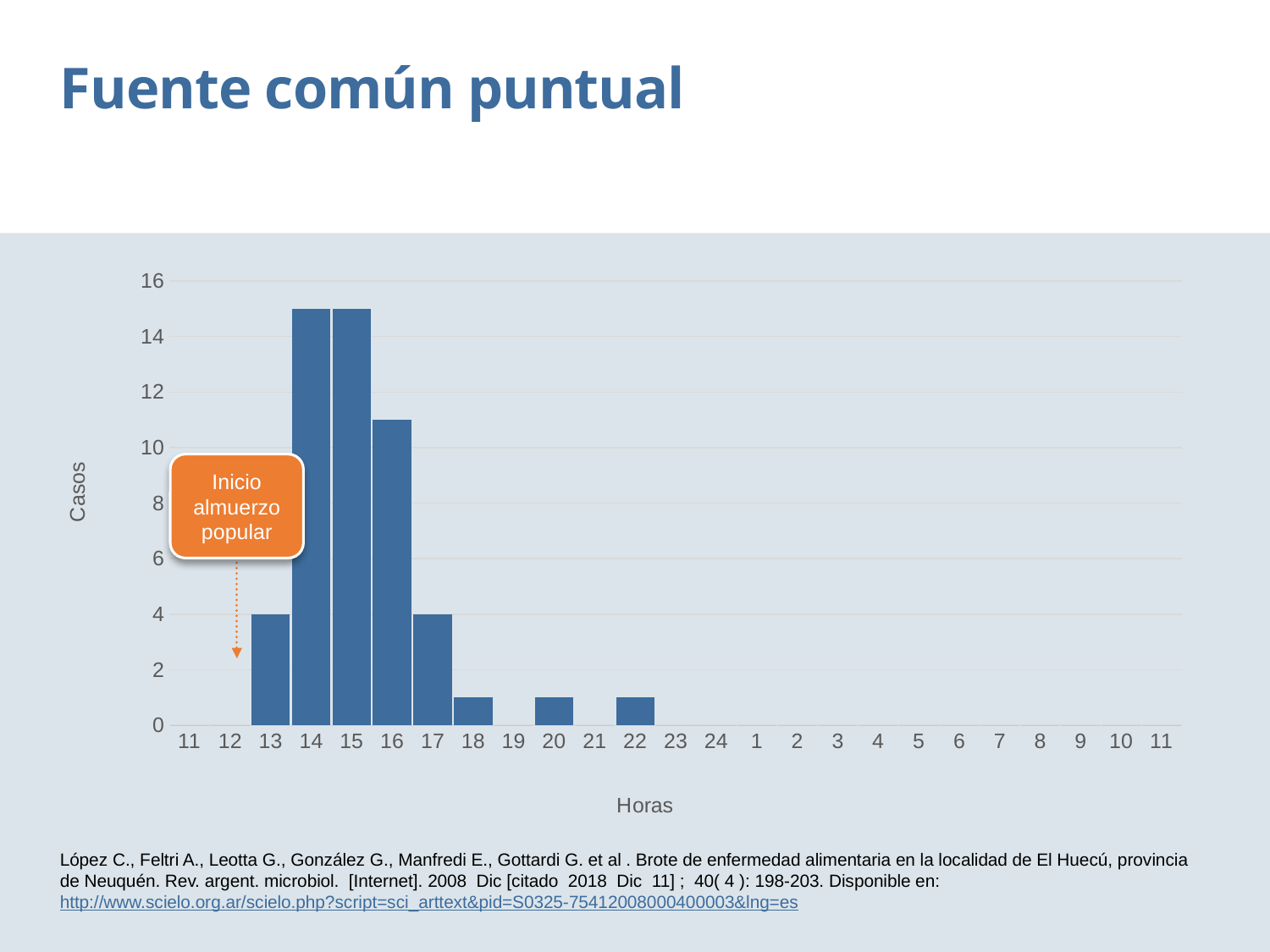
Is the value for hour 16 greater or less than 12? less How many hour labels are shown on the x axis? 25 What kind of chart is shown on the slide? bar chart What is the number of cases (Casos) at hour 17? 4 What is the title of the x axis? Horas Is the value for hour 16 greater or less than 10? greater Do the values rise or fall from hour 15 to hour 18? fall Is the value for hour 18 greater or less than 2? less Which has more cases, hour 13 or hour 14? hour 14 Which has more cases, hour 16 or hour 17? hour 16 What is the number of cases (Casos) at hour 13? 4